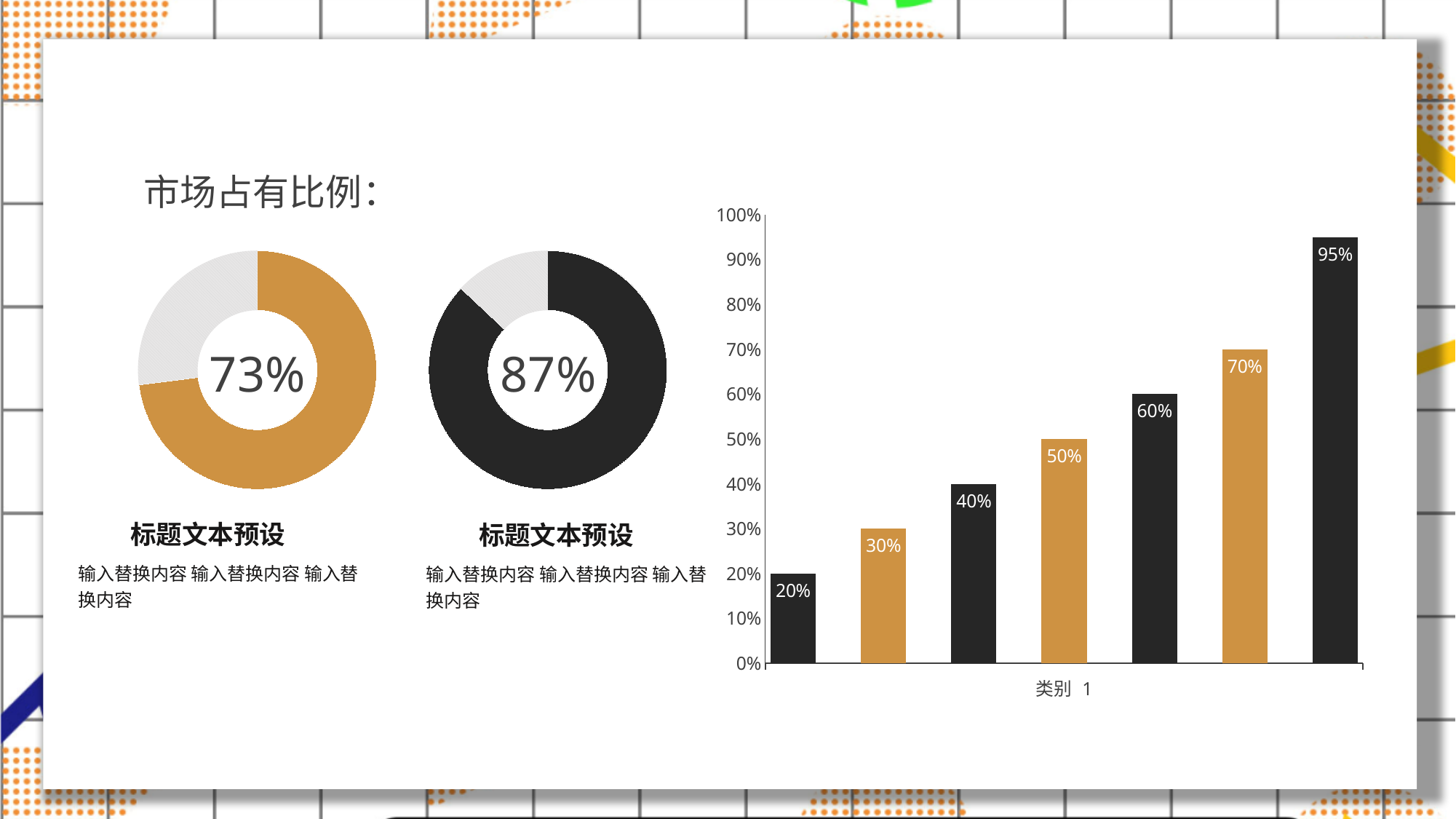
In the bar chart on the right, what is the value of the second bar from the left? 30% What kind of chart is shown on the right side of the slide? bar chart What percentage is shown in the centre of the left donut chart? 73% Which donut chart shows the larger percentage, the left one (73%) or the middle one (87%)? the middle one (87%) In the bar chart on the right, which is larger: the bar labelled 40% or the bar labelled 60%? 60% In the bar chart on the right, do the bar values rise or fall from left to right? rise In the bar chart on the right, what is the category label shown on the x axis? 类别 1 In the bar chart on the right, what is the difference between the tallest bar (95%) and the bar labelled 70%? 25% In the bar chart on the right, what is the value of the tallest bar? 95% In the bar chart on the right, how many bars are plotted? 7 In the bar chart on the right, what is the value of the shortest bar? 20% What percentage is shown in the centre of the middle donut chart? 87%